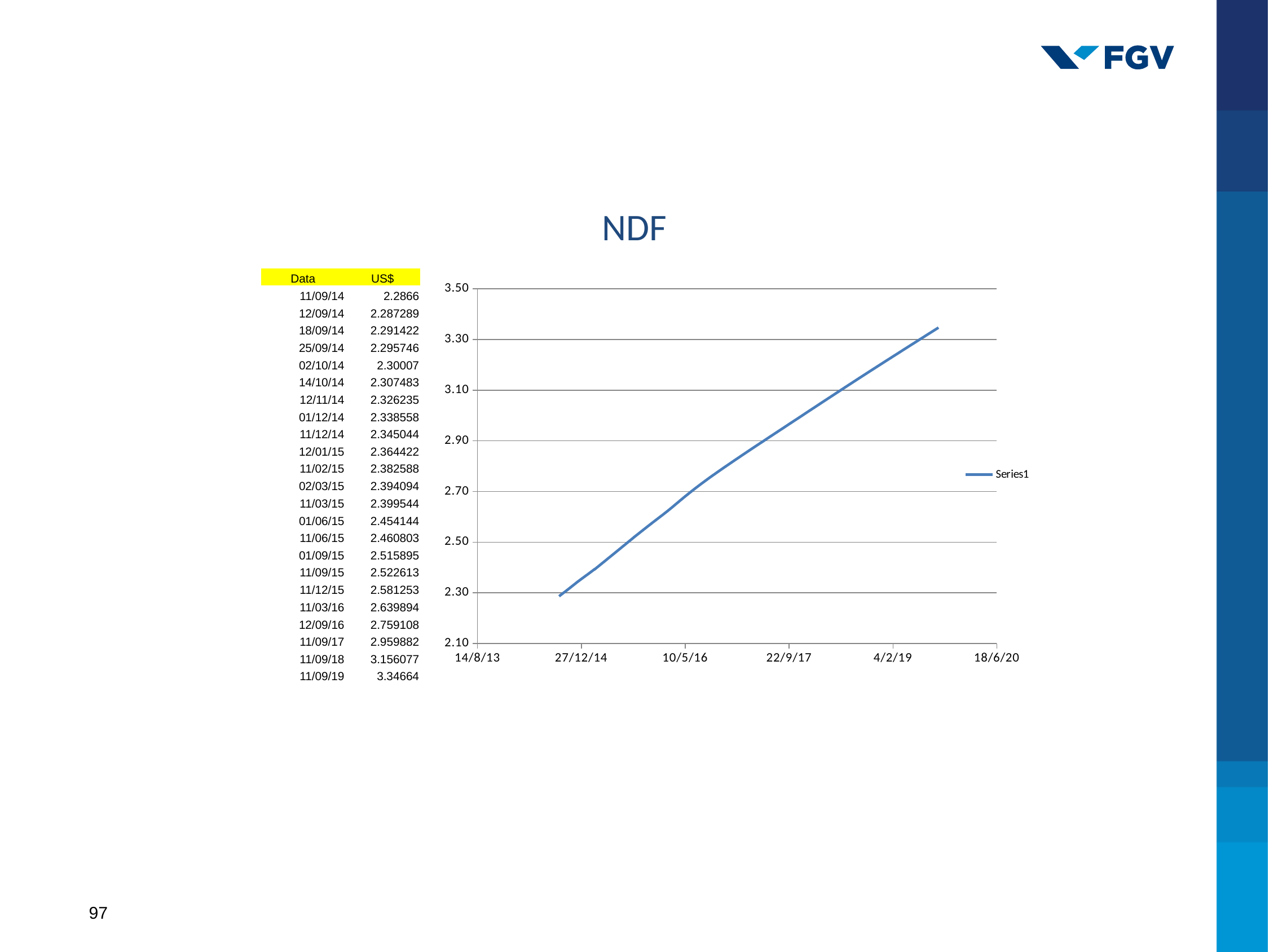
What is the name of the series shown in the legend? Series1 Do the values rise or fall along the x axis? rise According to the data table, what is the US$ value on 11/09/19? 3.34664 According to the data table, what is the US$ value on 11/09/14? 2.2866 Is the value of the line at 4/2/19 greater or less than 3.10? greater Which date has the lowest US$ value? 11/09/14 According to the data table, what is the US$ value on 11/09/18? 3.156077 What is the difference between the US$ value on 11/09/19 and on 11/09/14? 1.06004 What is the title of the chart? NDF How many series does the legend list? 1 Which date has the highest US$ value? 11/09/19 What kind of chart is shown on the slide? line chart